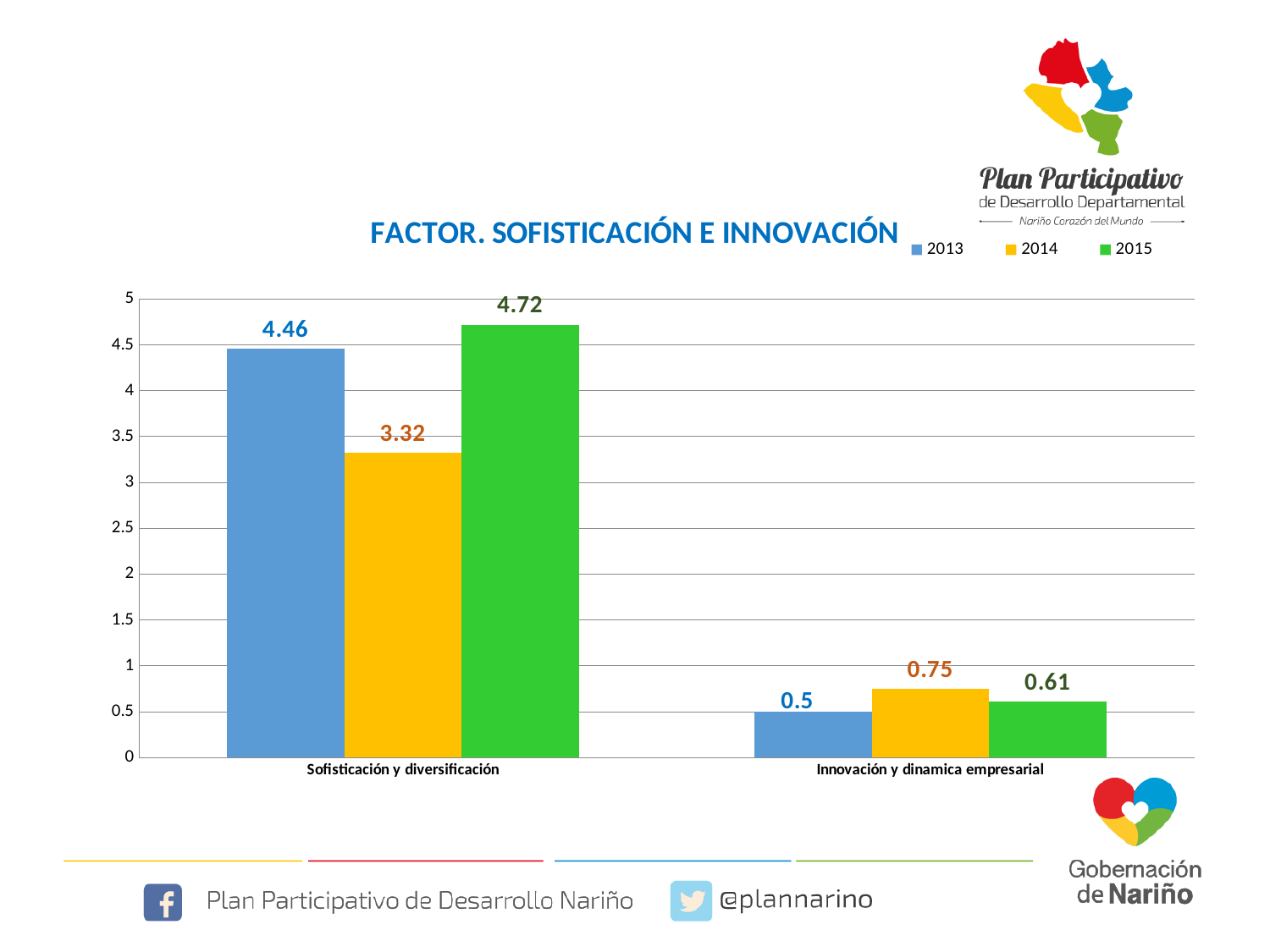
What is the value for 2013 in the Sofisticación y diversificación category? 4.46 What is the value for 2014 in the Innovación y dinamica empresarial category? 0.75 How many series does the legend list? 3 Which year has the lowest value in the Innovación y dinamica empresarial category? 2013 What is the value for 2015 in the Sofisticación y diversificación category? 4.72 What is the difference between the 2015 and 2014 values for Sofisticación y diversificación? 1.4 Is the 2014 value for Sofisticación y diversificación greater or less than 3.5? less What kind of chart is shown on the slide? Bar chart What is the title of the chart? FACTOR. SOFISTICACIÓN E INNOVACIÓN How many categories are shown on the x axis? 2 Which year has the highest value in the Sofisticación y diversificación category? 2015 Which is larger for Innovación y dinamica empresarial: the 2014 value or the 2015 value? 2014